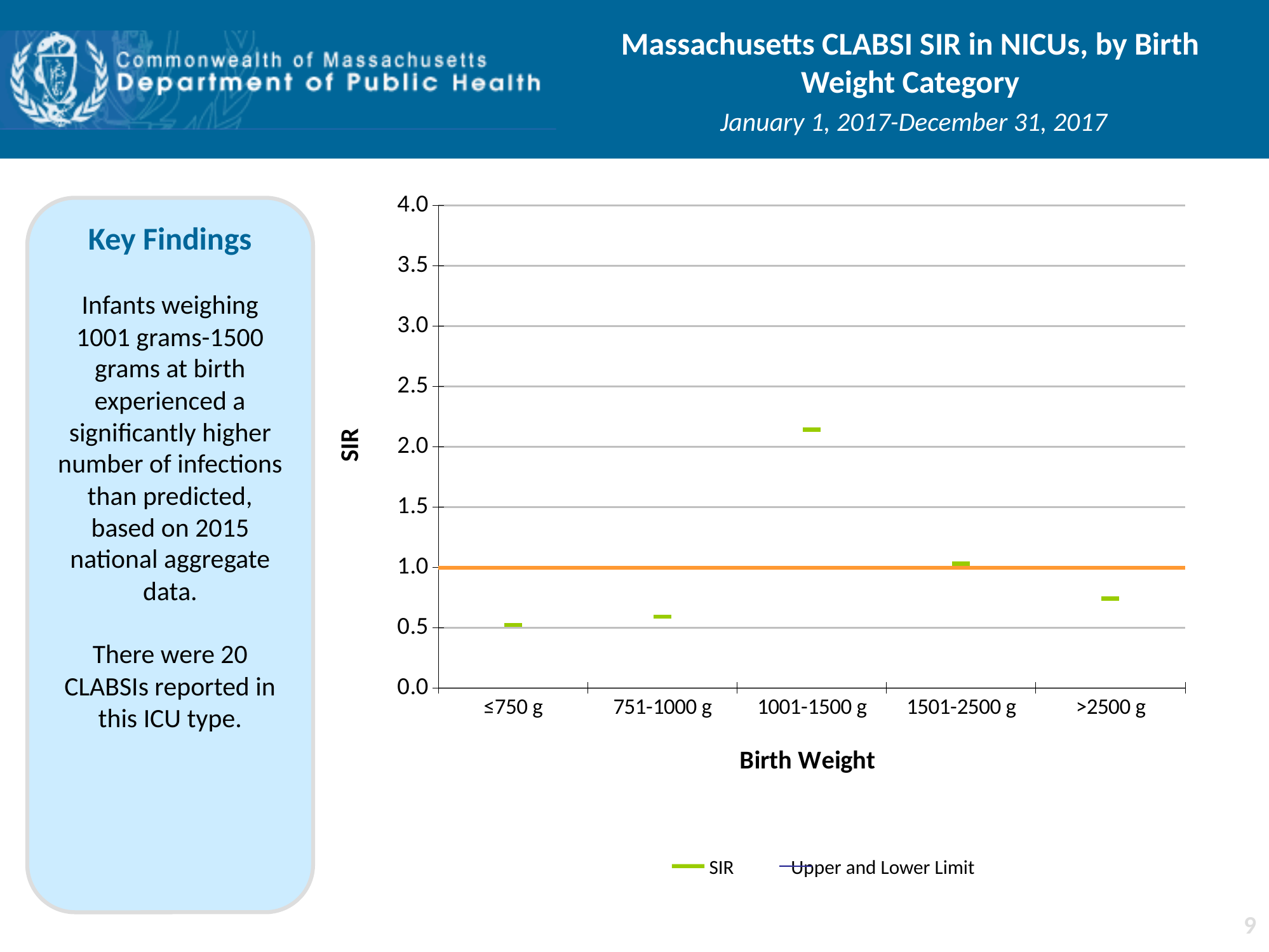
Is the SIR for ≤750 g greater or less than 1.0? less How many series does the legend list? 2 What is the title of the x axis? Birth Weight Which birth weight category has the highest SIR? 1001-1500 g Is the SIR for 751-1000 g greater or less than 1.0? less Is the SIR for 1001-1500 g greater or less than 2.5? less What is the title of the y axis? SIR How many birth weight categories are shown on the x axis? 5 Which has a higher SIR, 1001-1500 g or >2500 g? 1001-1500 g Which has a higher SIR, 1501-2500 g or ≤750 g? 1501-2500 g